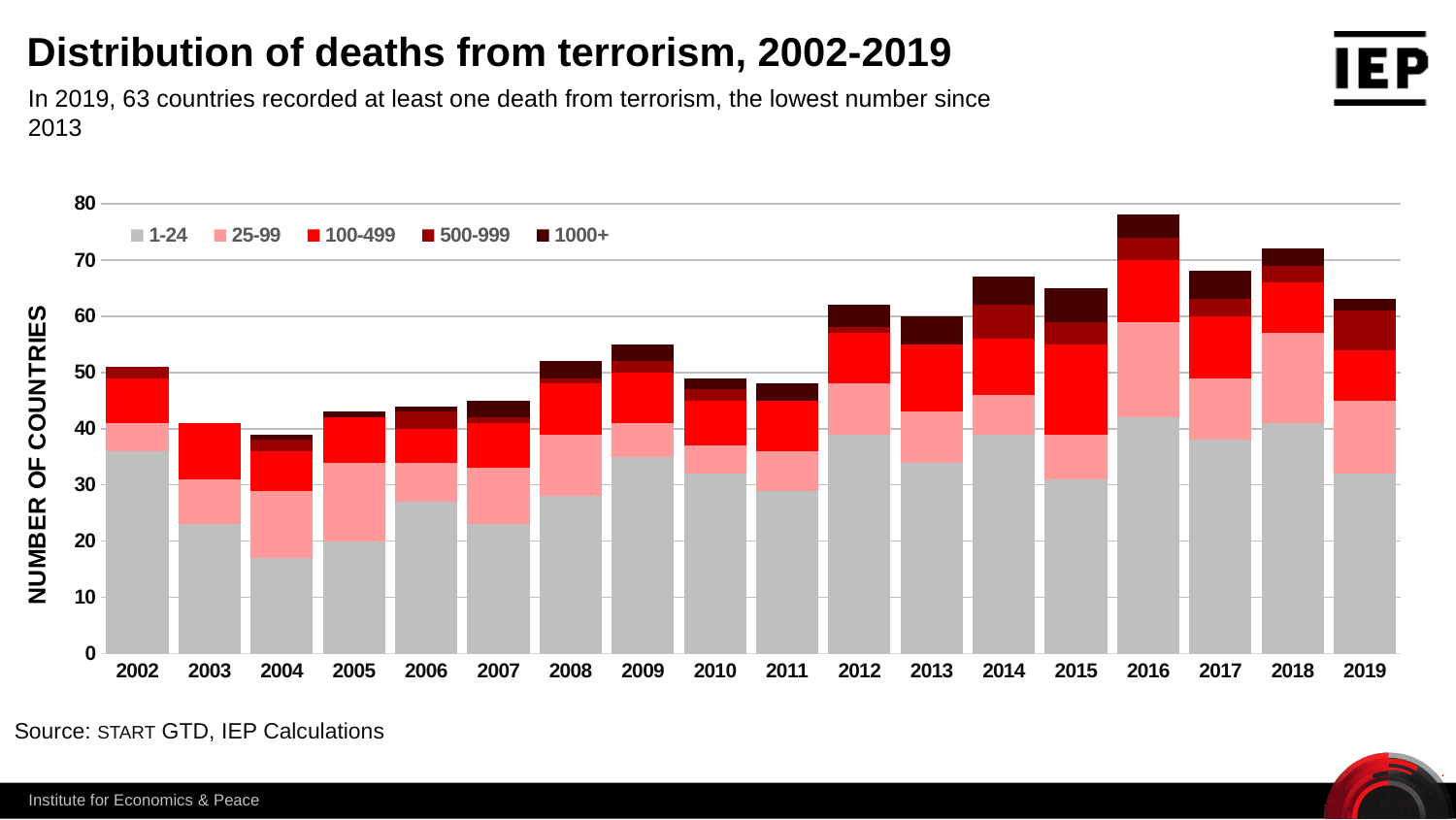
Is the total number of countries for 2011 greater or less than 50? less What is the label on the y axis? NUMBER OF COUNTRIES According to the slide, how many countries recorded at least one death from terrorism in 2019? 63 How many series does the legend list? 5 How many years are shown along the x axis? 18 Which year has the highest total number of countries? 2016 Which year has the larger total number of countries, 2002 or 2004? 2002 What kind of chart is shown on the slide? bar chart Is the total number of countries for 2005 greater or less than 40? greater Which year has the larger total number of countries, 2016 or 2019? 2016 Is the total number of countries for 2016 greater or less than 70? greater